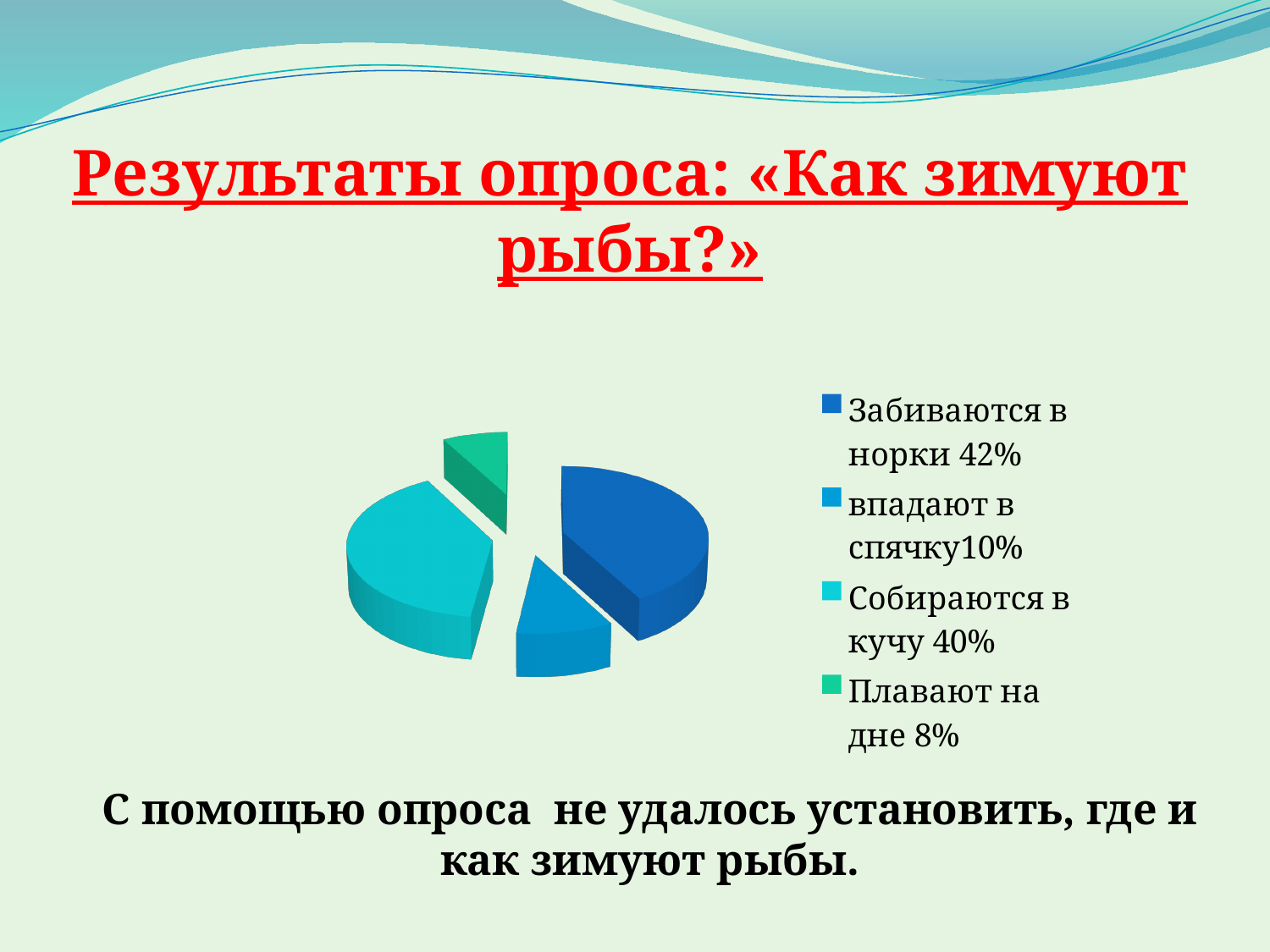
What is the title of the slide containing the chart? Результаты опроса: «Как зимуют рыбы?» What share of respondents answered «Плавают на дне»? 8% What is the combined share of «впадают в спячку» and «Плавают на дне»? 18% What share of respondents answered «Собираются в кучу»? 40% What share of respondents answered «Забиваются в норки»? 42% What share of respondents answered «впадают в спячку»? 10% How many slices does the pie chart have? 4 What is the difference in percentage points between «Забиваются в норки» and «Собираются в кучу»? 2 What kind of chart is shown on the slide? Pie chart Which answer has the largest share in the pie chart? Забиваются в норки Which answer has the smallest share in the pie chart? Плавают на дне Which is larger: the share for «впадают в спячку» or the share for «Плавают на дне»? впадают в спячку